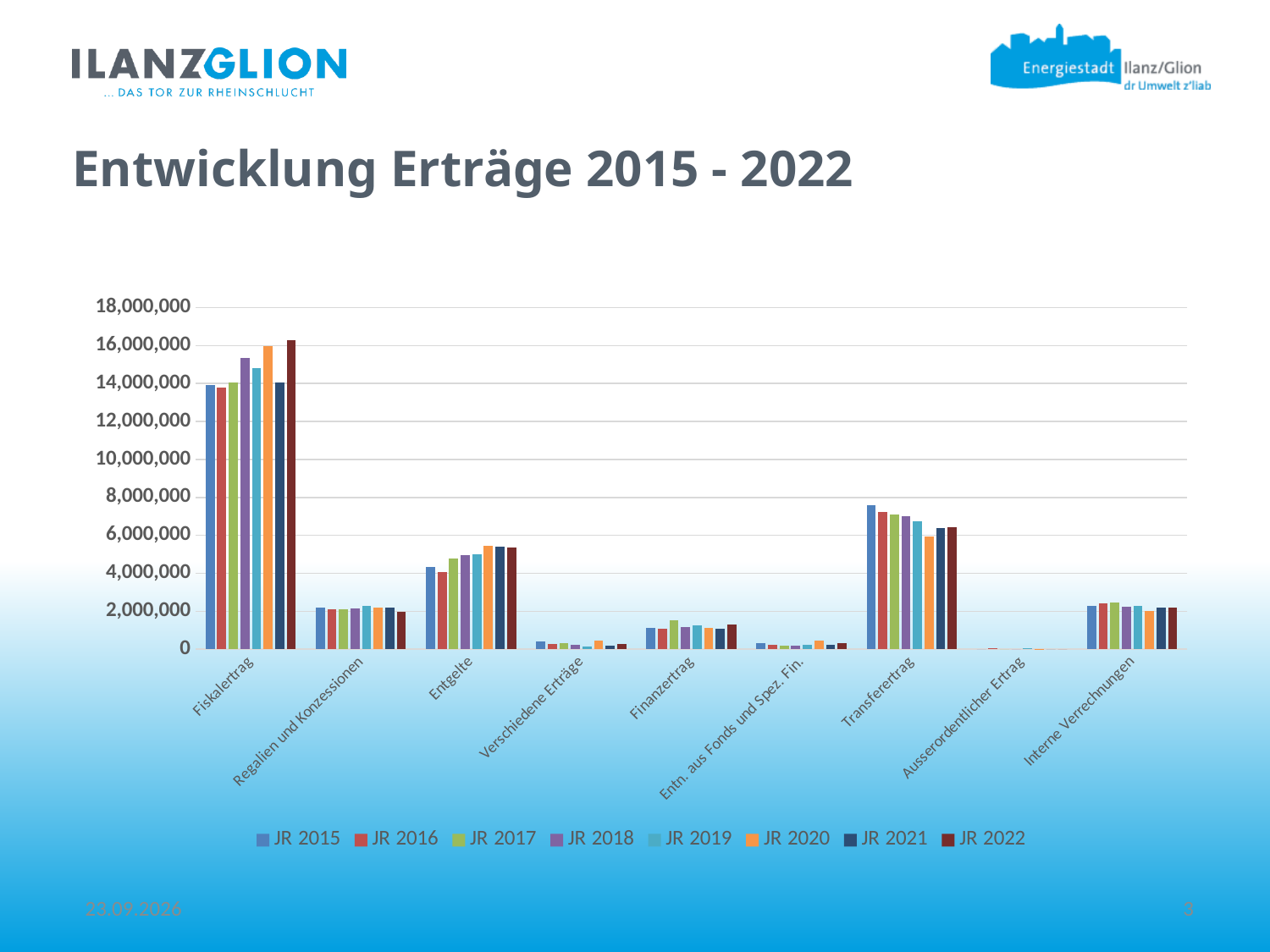
How many categories are shown on the x axis of the chart? 9 Which category has the lowest values in the chart? Ausserordentlicher Ertrag For Transferertrag, which is larger: JR 2015 or JR 2020? JR 2015 Within the Transferertrag category, which series has the highest bar? JR 2015 How many series does the legend list? 8 What is the title of the slide containing the chart? Entwicklung Erträge 2015 - 2022 Is the value for Fiskalertrag in JR 2022 greater or less than 14,000,000? greater What kind of chart is shown on the slide? bar chart Which is larger for JR 2020: Fiskalertrag or Transferertrag? Fiskalertrag Is the value for Entgelte in JR 2015 greater or less than 6,000,000? less Which category has the highest values in the chart? Fiskalertrag Is the value for Transferertrag in JR 2015 greater or less than 6,000,000? greater